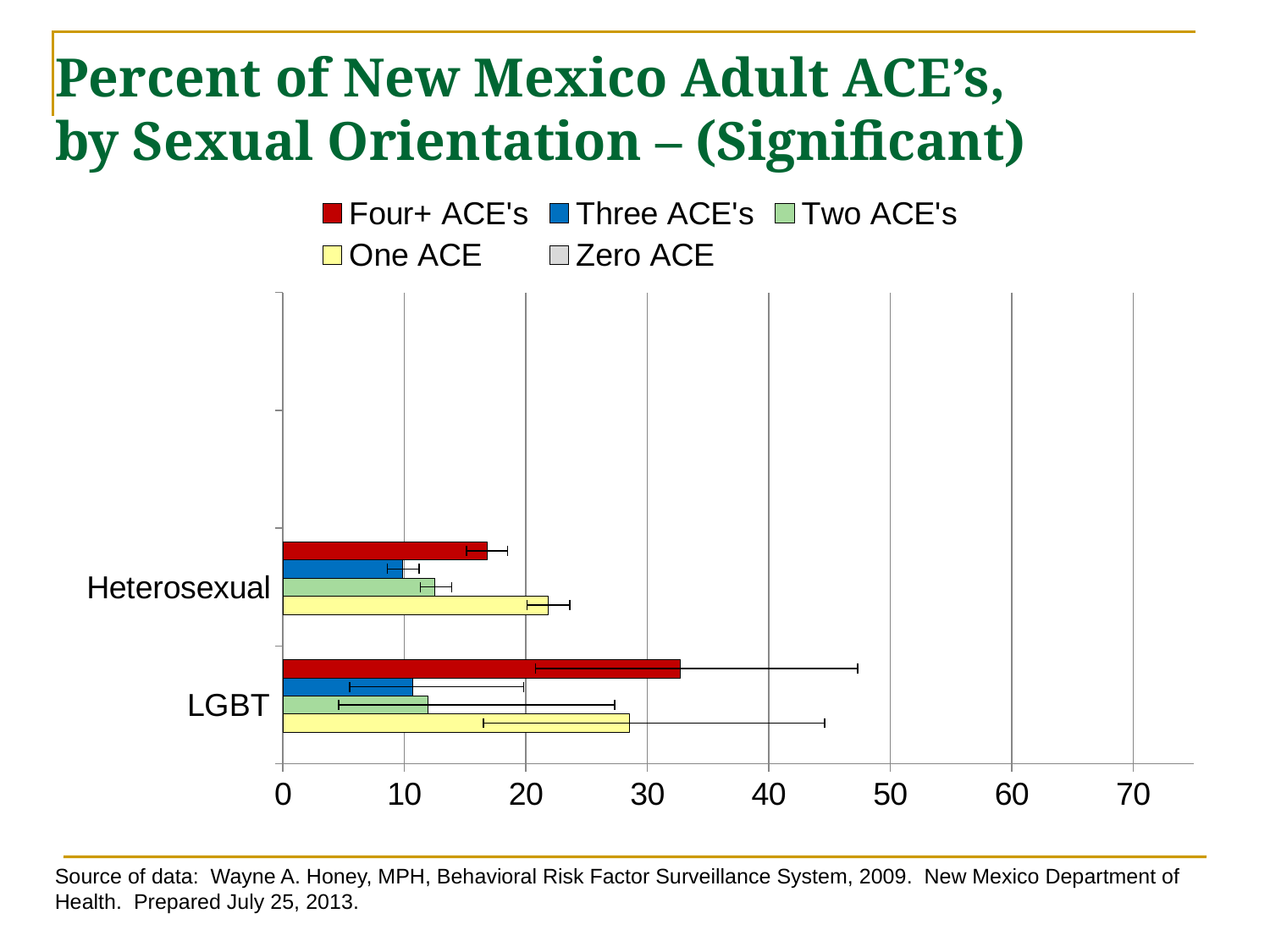
What colour represents the Four+ ACE's series in the legend? red Is the Four+ ACE's value for Heterosexual greater or less than 20? less How many sexual orientation categories have bars plotted on the chart? 2 Is the One ACE value for LGBT greater or less than 20? greater Which category has the larger Four+ ACE's value, LGBT or Heterosexual? LGBT Which series has the longest bar for the Heterosexual category? One ACE Which series has the shortest visible bar for the Heterosexual category? Three ACE's Is the Two ACE's value for LGBT greater or less than 20? less Which series has the longest bar for the LGBT category? Four+ ACE's What kind of chart is shown on the slide? bar chart How many series does the legend list? 5